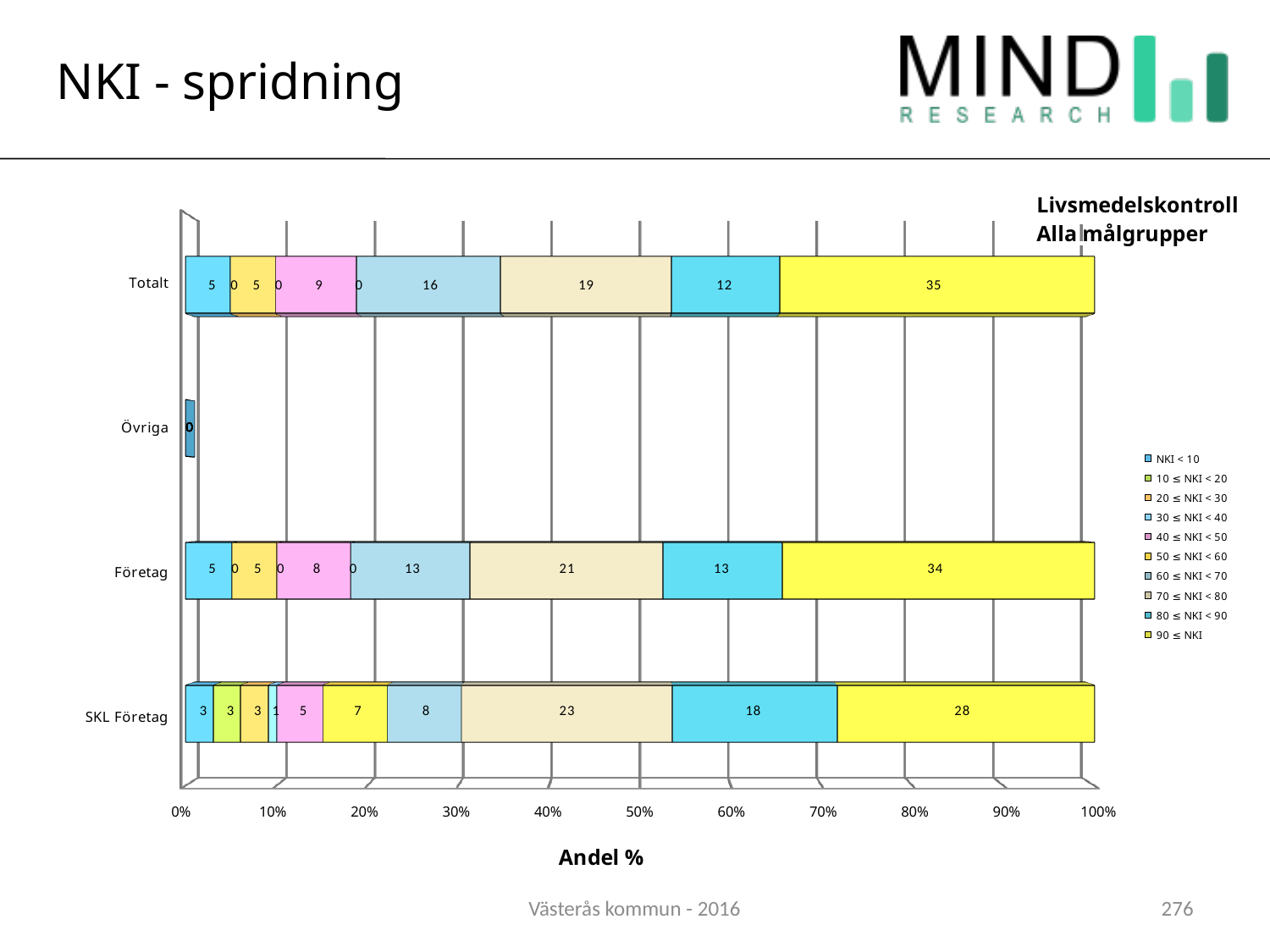
What is the difference between the 90 ≤ NKI segment for Totalt and for SKL Företag? 7 What kind of chart is shown on the slide? Stacked bar chart What is the value of the 80 ≤ NKI < 90 segment for Företag? 13 How many categories are shown on the vertical axis? 4 What is the value of the 70 ≤ NKI < 80 segment for SKL Företag? 23 How many series does the legend list? 10 Which category has the largest 90 ≤ NKI segment? Totalt What is the label of the horizontal axis? Andel % Which is larger: the 80 ≤ NKI < 90 segment for SKL Företag or for Totalt? SKL Företag What text appears in the top-right corner of the chart area? Livsmedelskontroll Alla målgrupper What is the value of the 90 ≤ NKI segment for Totalt? 35 What is the value of the 60 ≤ NKI < 70 segment for Totalt? 16